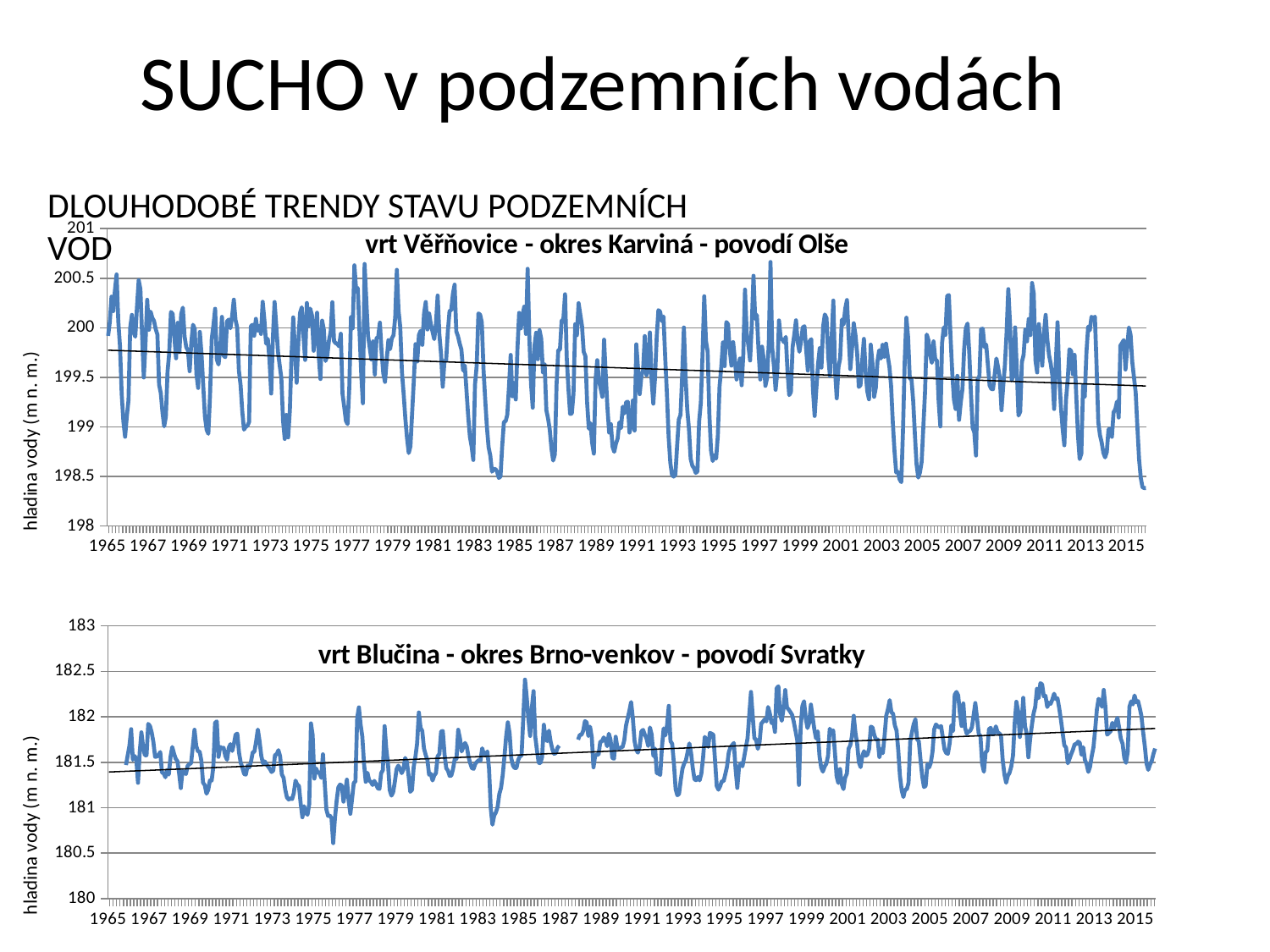
What kind of chart is the bottom chart, 'vrt Blučina - okres Brno-venkov - povodí Svratky'? line chart What is the title of the top chart? vrt Věřňovice - okres Karviná - povodí Olše In the top chart (vrt Věřňovice), does the straight trend line rise or fall from 1965 to 2015? fall In the bottom chart (vrt Blučina), does the straight trend line rise or fall from 1965 to 2015? rise What kind of chart is the top chart, 'vrt Věřňovice - okres Karviná - povodí Olše'? line chart In the top chart (vrt Věřňovice), is the lowest water level reached near 2015 greater or less than 198.5? less In the bottom chart (vrt Blučina), is the water level at the start of the series in 1965 greater or less than 182? less What is the label on the vertical axis of the bottom chart? hladina vody (m n. m.) In the bottom chart (vrt Blučina), is the lowest water level reached around 1976 greater or less than 181? less